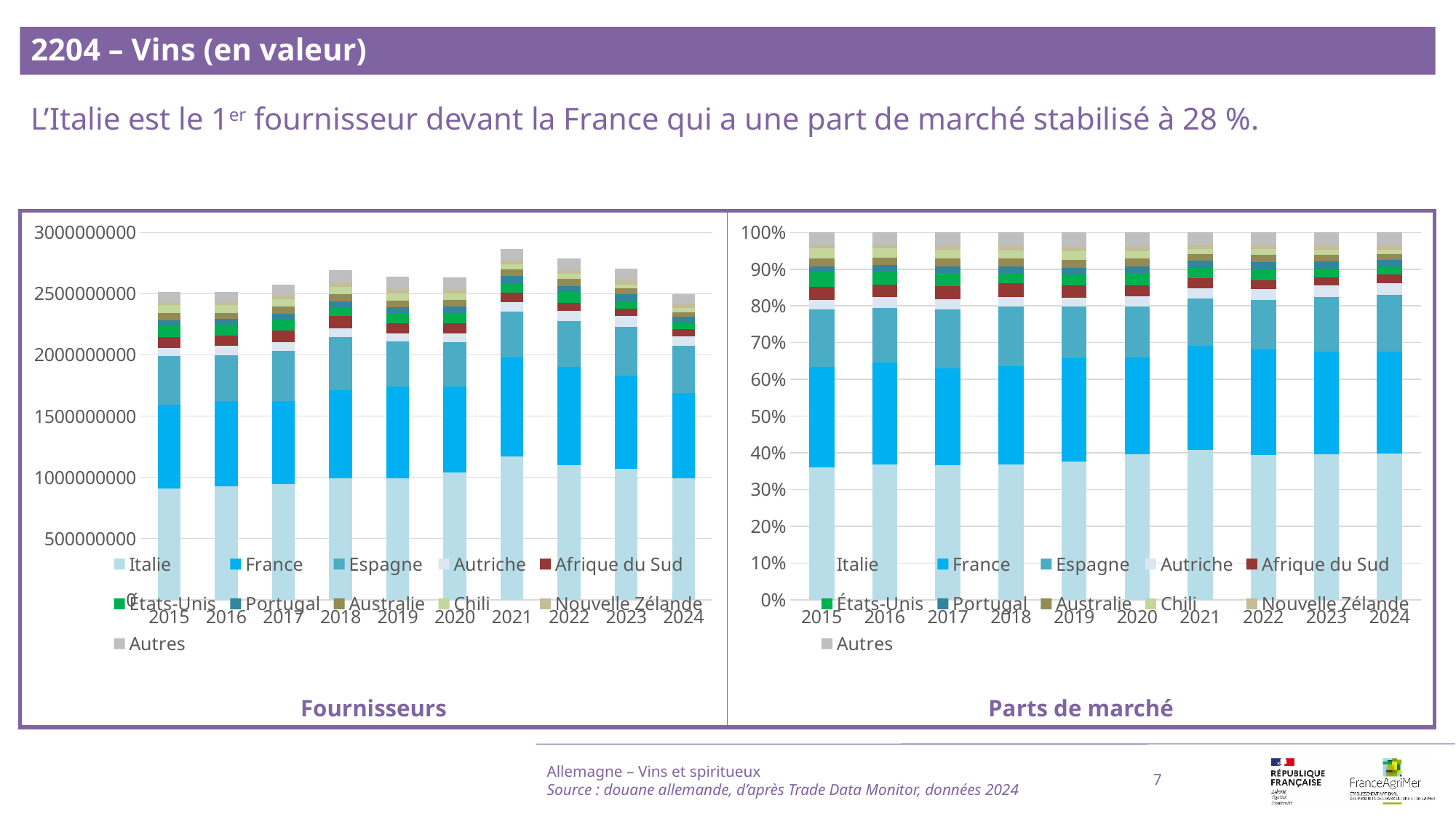
What kind of chart is the 'Fournisseurs' chart? stacked bar chart In the 'Fournisseurs' chart, is the total for 2021 greater or less than 2500000000? greater Which series is listed first in the legend of the 'Parts de marché' chart? Italie In the 'Fournisseurs' chart, is the value for Italie in 2021 greater or less than 1000000000? greater In the 'Parts de marché' chart, is the share of Italie in 2015 greater or less than 30%? greater How many series does the legend of the 'Fournisseurs' chart list? 11 How many years are shown on the x axis of the 'Parts de marché' chart? 10 In the 'Parts de marché' chart, which is larger in 2024: the share of Italie or the share of France? Italie In the 'Fournisseurs' chart, which year has the highest total bar? 2021 In the 'Parts de marché' chart, does the share of Italie rise or fall from 2015 to 2024? rise